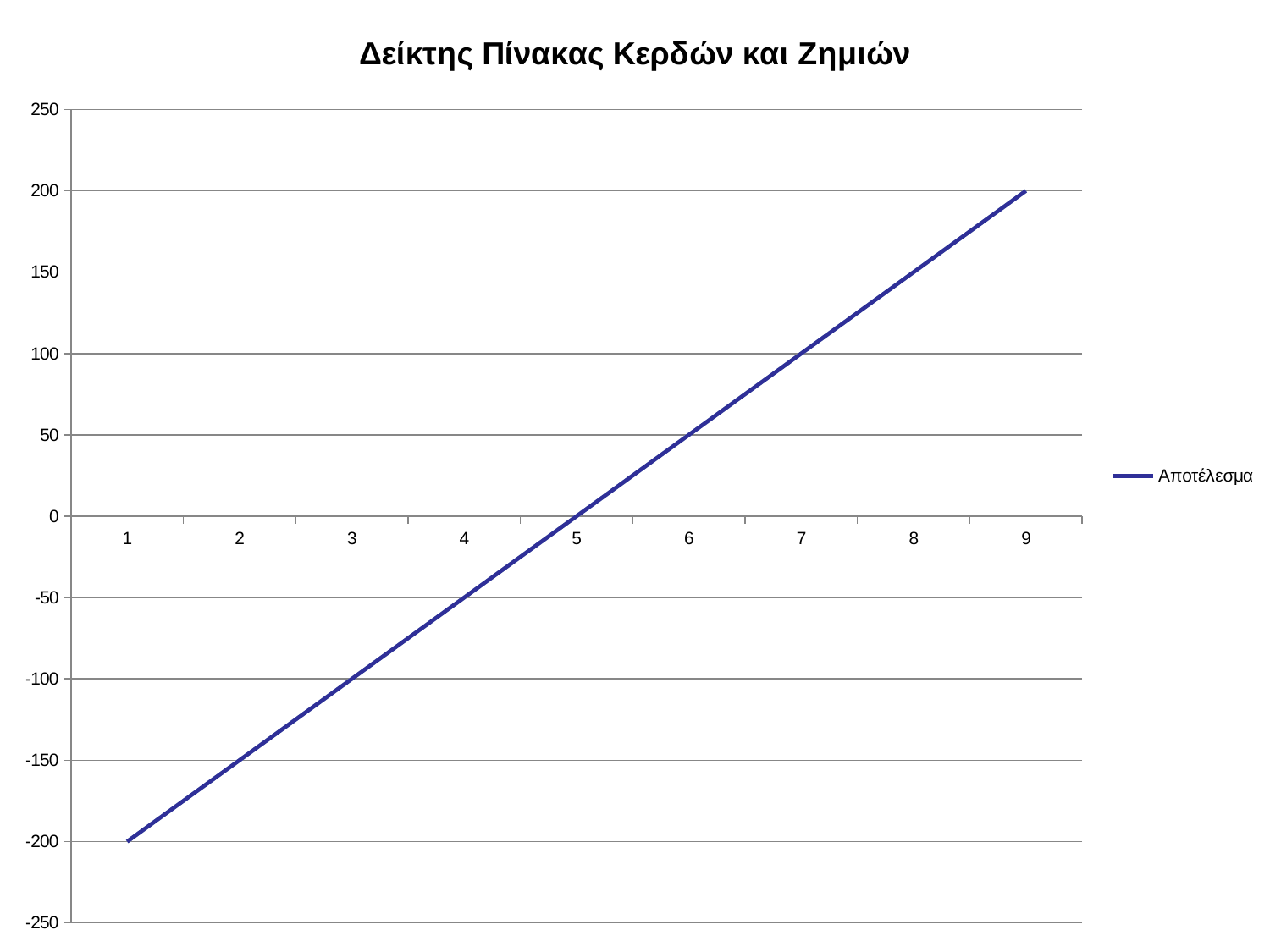
What is the value of Αποτέλεσμα at x = 5? 0 At which x value is Αποτέλεσμα highest? 9 Is the value of Αποτέλεσμα at x = 7 greater or less than 50? greater What kind of chart is shown on the slide? line chart What is the name of the series shown in the legend? Αποτέλεσμα How many points are plotted along the x axis? 9 How many series does the legend list? 1 Do the values of Αποτέλεσμα rise or fall as x increases from 1 to 9? rise At which x value is Αποτέλεσμα lowest? 1 What is the title of the chart? Δείκτης Πίνακας Κερδών και Ζημιών What is the value of Αποτέλεσμα at x = 1? -200 What is the value of Αποτέλεσμα at x = 9? 200